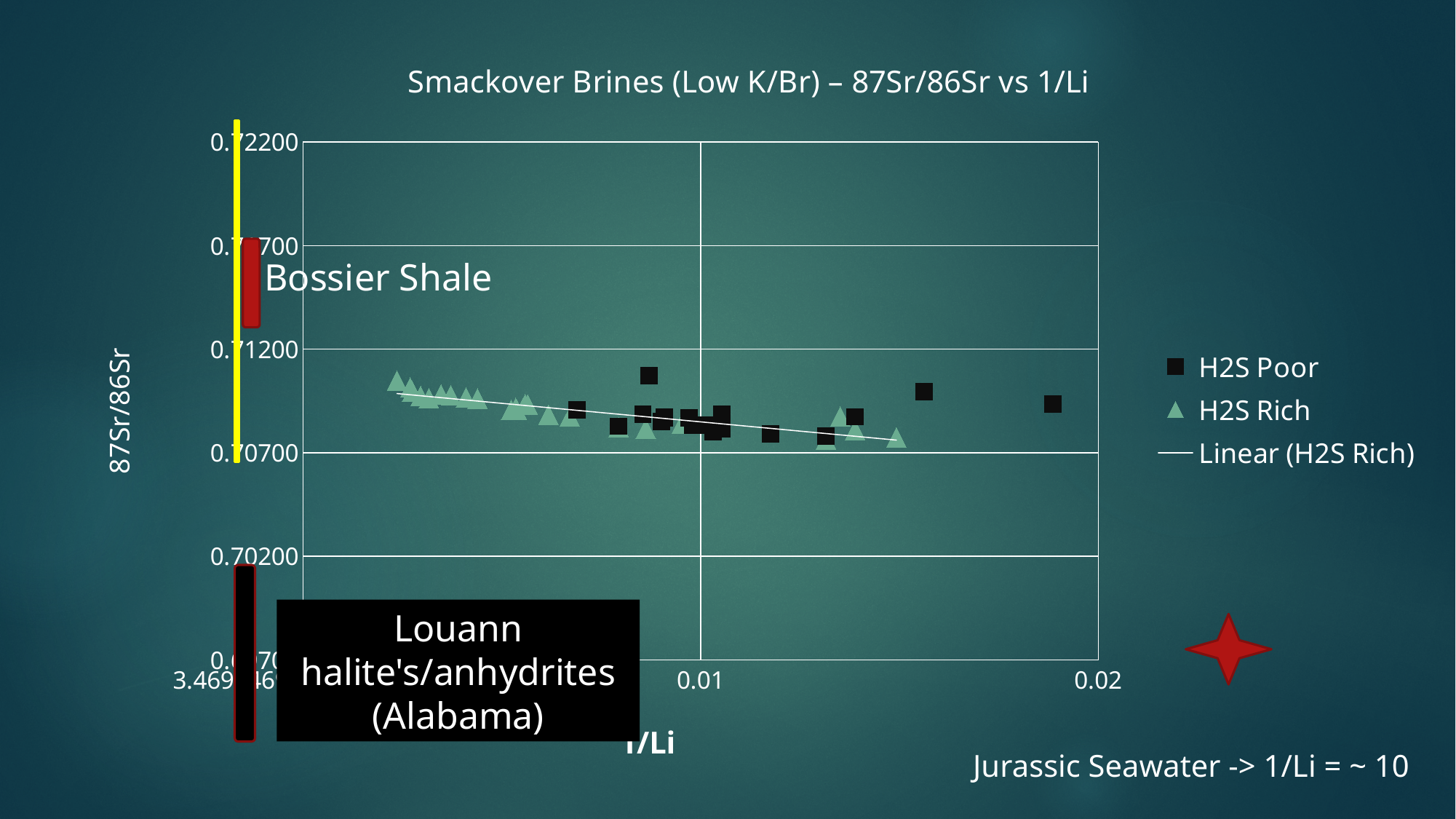
What is the label of the vertical axis? 87Sr/86Sr Which series contains the point with the largest 1/Li value? H2S Poor Which series contains the point with the smallest 1/Li value? H2S Rich Are the H2S Poor values of 87Sr/86Sr greater or less than 0.71200? less Which marker shape is used for the H2S Rich series? Triangle How many entries does the chart legend list? 3 What is the label of the horizontal axis? 1/Li What is the title of the chart? Smackover Brines (Low K/Br) – 87Sr/86Sr vs 1/Li What are the legend entries of the chart? H2S Poor, H2S Rich, Linear (H2S Rich) What kind of chart is shown on the slide? Scatter chart Does the linear trend line for H2S Rich rise or fall as 1/Li increases? Fall Are the H2S Rich values of 87Sr/86Sr greater or less than 0.71200? less